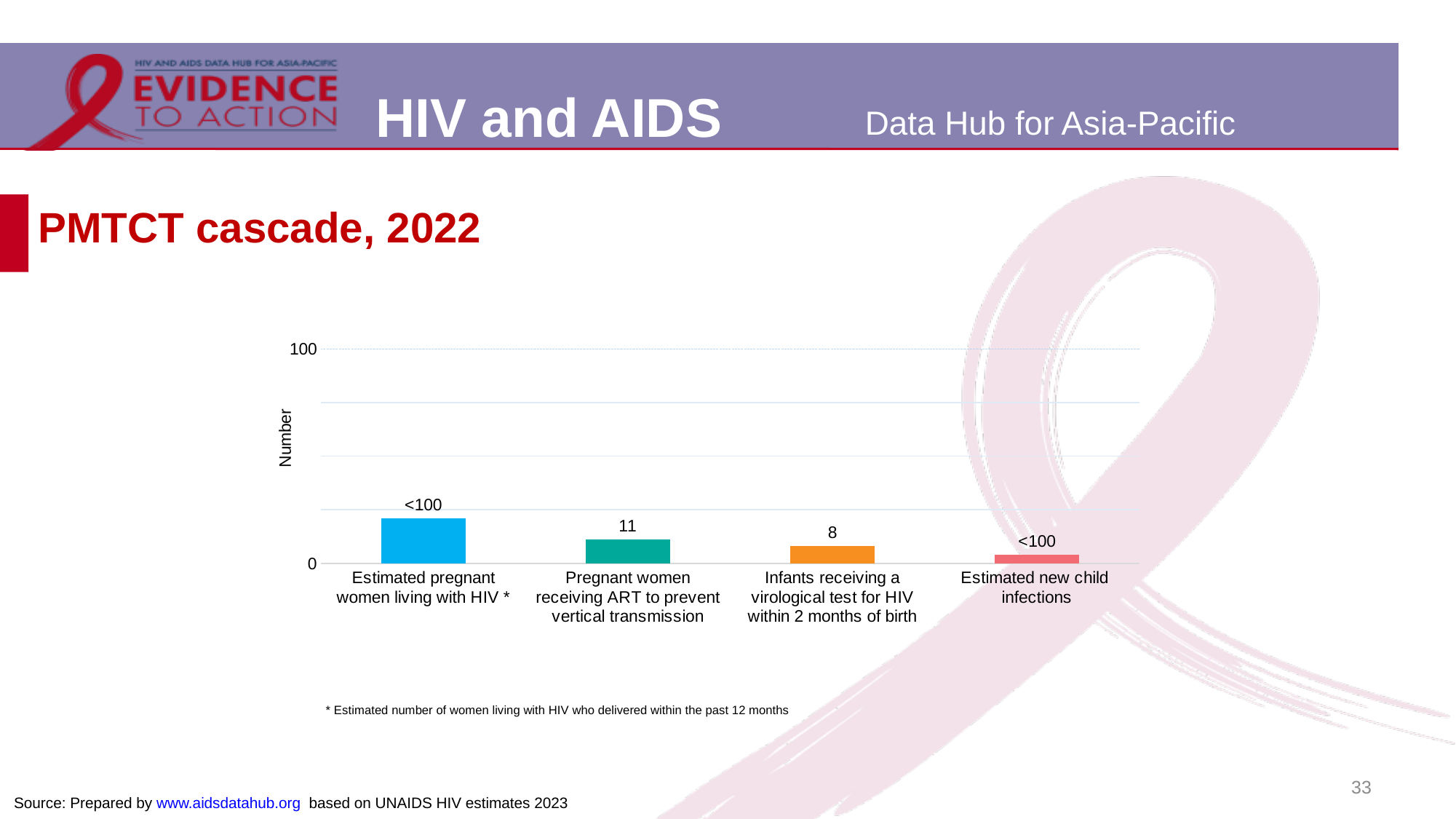
What is the data label shown above the bar for estimated pregnant women living with HIV? <100 What kind of chart is shown on the slide? Bar chart Which category has the shortest bar in the chart? Estimated new child infections Is the value for pregnant women receiving ART to prevent vertical transmission greater or less than 100? less What is the data label on the bar for pregnant women receiving ART to prevent vertical transmission? 11 What is the difference between the number of pregnant women receiving ART to prevent vertical transmission and the number of infants receiving a virological test for HIV within 2 months of birth? 3 What is the label of the vertical axis of the chart? Number Which is larger: the value for pregnant women receiving ART to prevent vertical transmission or the value for infants receiving a virological test for HIV within 2 months of birth? Pregnant women receiving ART to prevent vertical transmission What is the data label on the bar for infants receiving a virological test for HIV within 2 months of birth? 8 Which category has the tallest bar in the chart? Estimated pregnant women living with HIV * What is the data label shown above the bar for estimated new child infections? <100 How many categories are shown on the x axis of the chart? 4